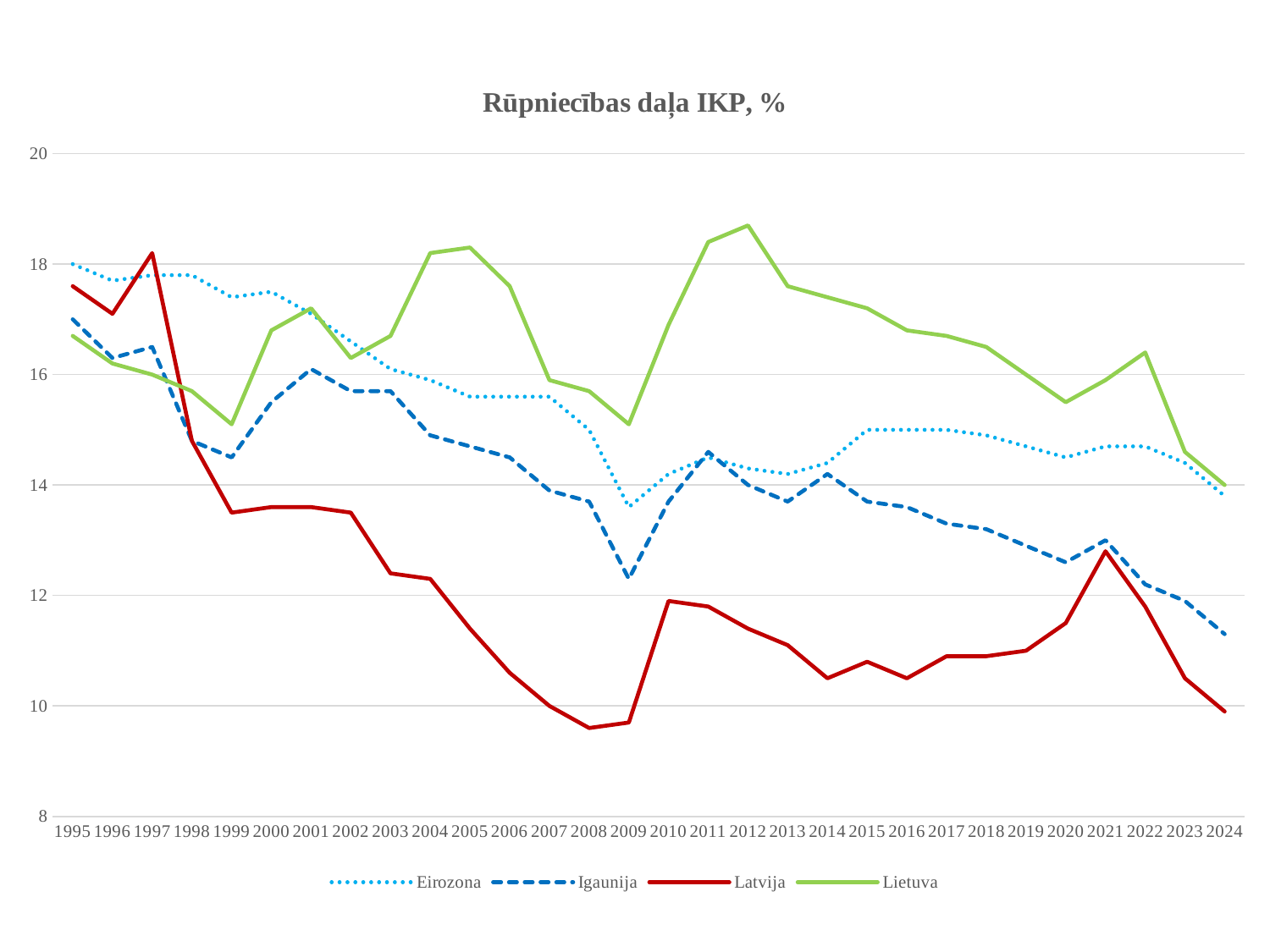
What kind of chart is shown on the slide? line chart Is the value for Eirozona in 2009 greater or less than 14? less Which series has the lowest value in 2024? Latvija Is the value for Latvija in 2008 greater or less than 10? less Which series is drawn with a solid red line? Latvija What is the title of the chart? Rūpniecības daļa IKP, % In 2024, which is larger: the value for Igaunija or the value for Latvija? Igaunija Is the value for Lietuva in 2012 greater or less than 18? greater Which series has the highest value in 2012? Lietuva How many years are shown along the x axis? 30 How many series does the legend list? 4